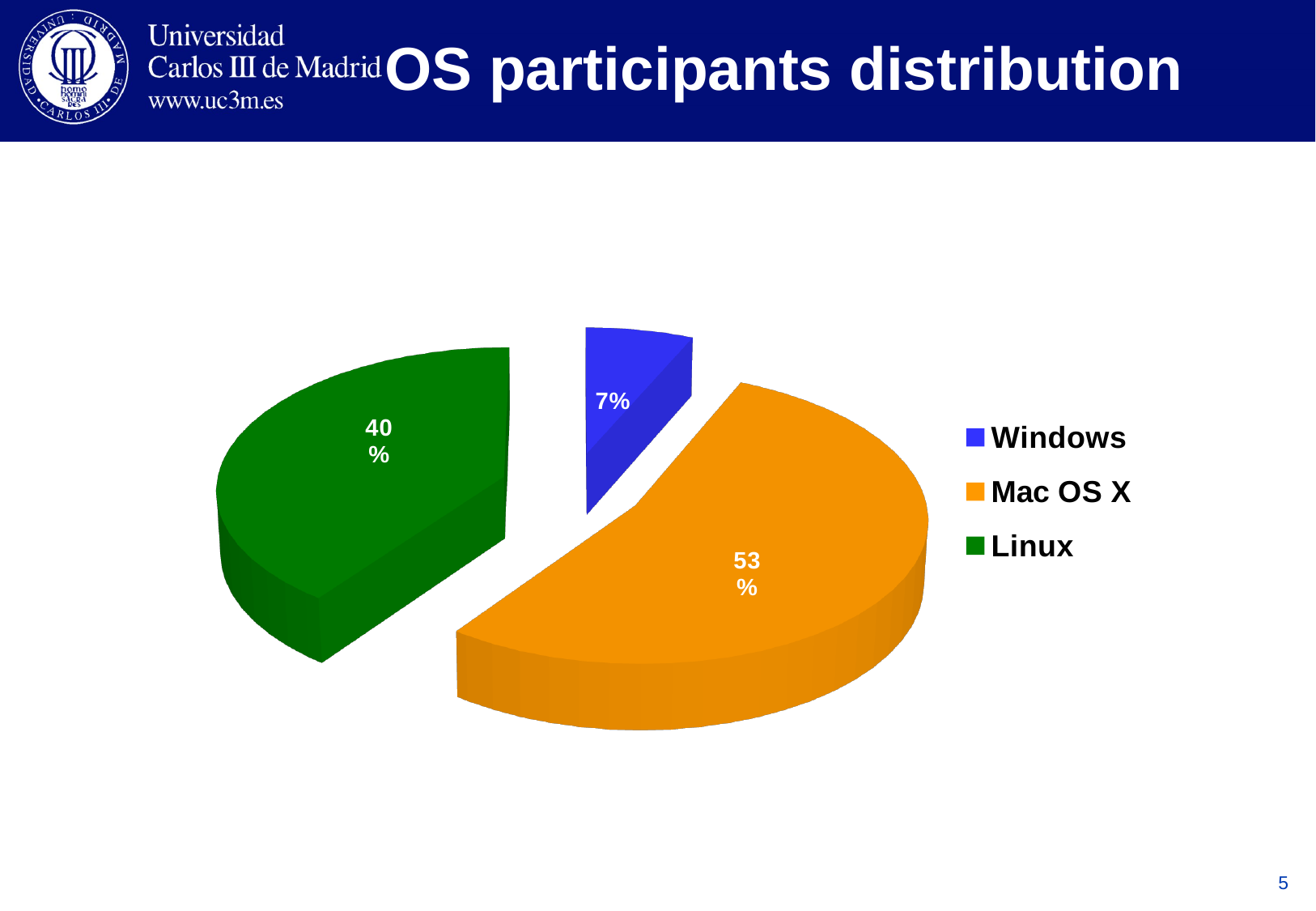
What is the difference in percentage points between the Linux and Windows shares? 33 What kind of chart is shown on the slide? Pie chart Which has a larger share, Linux or Windows? Linux What share of participants use Windows? 7% Which operating system has the smallest share of participants? Windows What is the difference in percentage points between the Mac OS X and Linux shares? 13 What share of participants use Mac OS X? 53% Which operating system has the largest share of participants? Mac OS X Which colour represents Linux in the pie chart? Green What share of participants use Linux? 40% What is the title of the slide? OS participants distribution How many operating systems are shown in the pie chart? 3